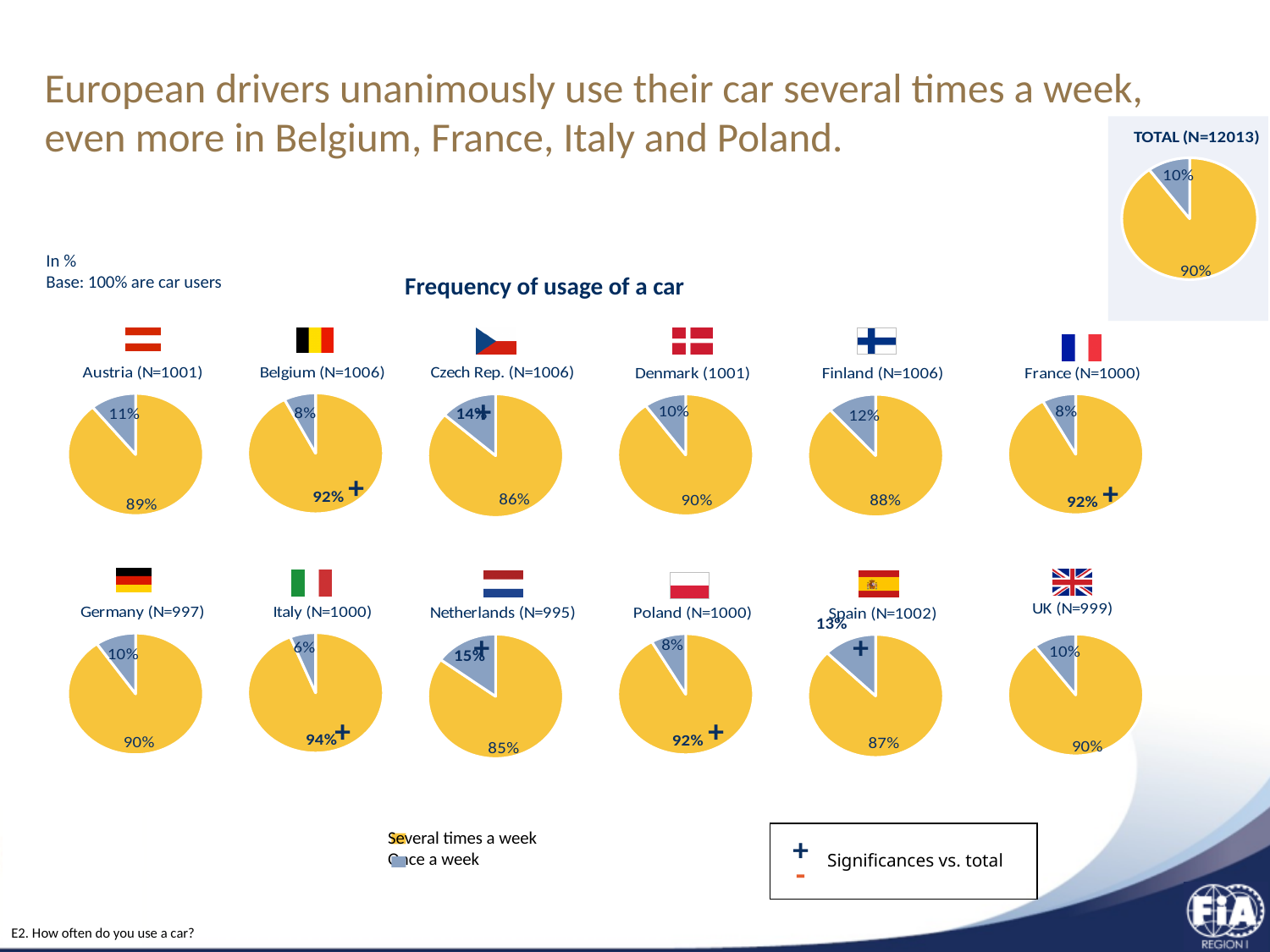
Across the country pie charts, which country has the lowest share of drivers using their car several times a week? Netherlands How many slices does the Spain (N=1002) pie chart have? 2 What type of chart is used to show the frequency of car usage for each country? Pie chart Which is larger: the 'once a week' share in the Finland pie chart or in the Austria pie chart? Finland In the Italy (N=1000) pie chart, what percentage of drivers use their car once a week? 6% In the Netherlands (N=995) pie chart, what percentage of drivers use their car several times a week? 85% In the TOTAL (N=12013) pie chart, what share of drivers use their car several times a week? 90% Across the country pie charts, which country has the highest share of drivers using their car several times a week? Italy In the Czech Rep. (N=1006) pie chart, what percentage of drivers use their car once a week? 14% How many categories does the legend list for the frequency of usage pie charts? 2 In the Poland (N=1000) pie chart, what is the total of the two slices? 100% What is the difference between the 'several times a week' share in the Italy pie chart and in the Netherlands pie chart? 9%